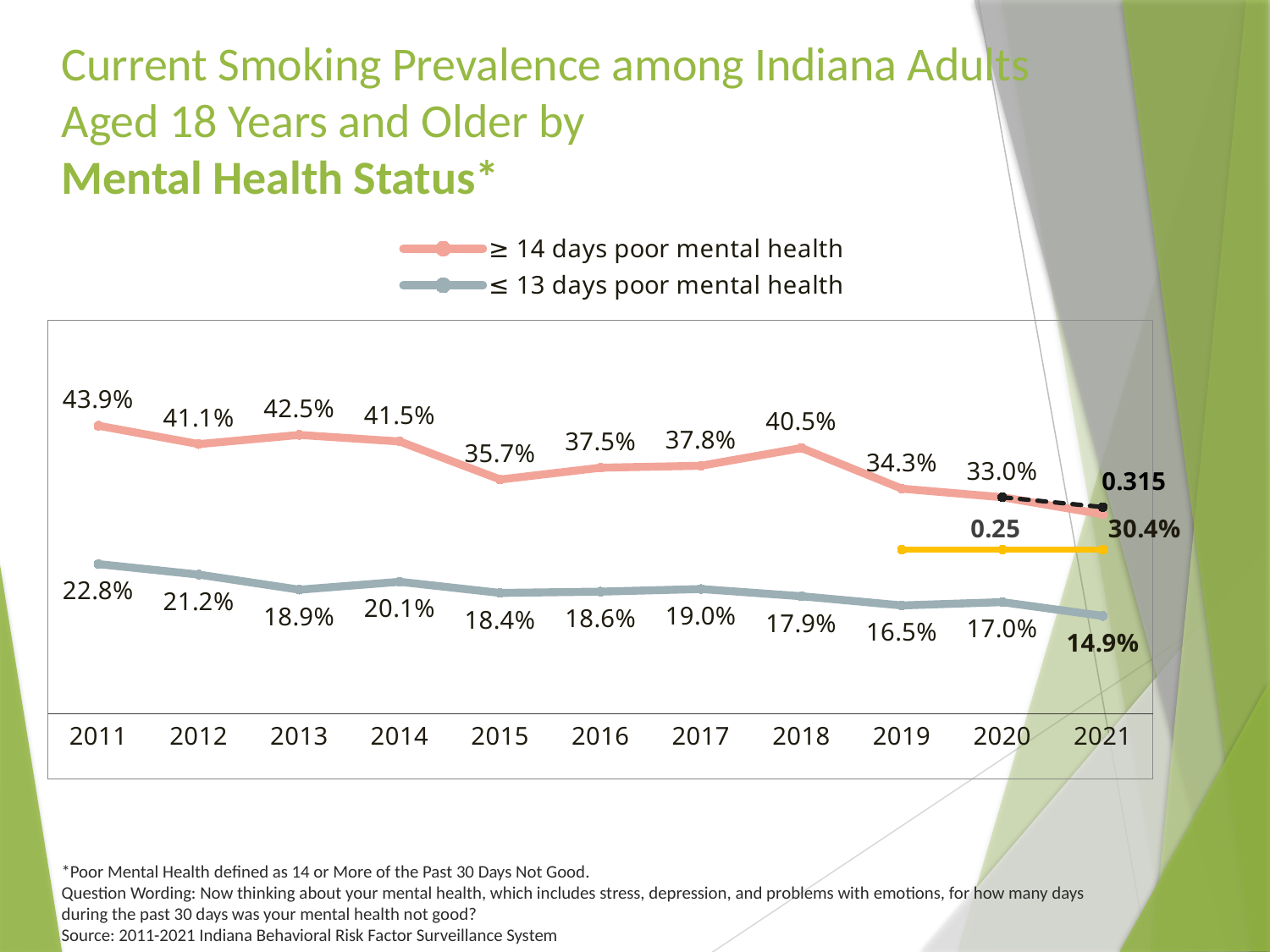
What is the current smoking prevalence for adults with ≤ 13 days poor mental health in 2021? 14.9% What is the current smoking prevalence for adults with ≥ 14 days poor mental health in 2011? 43.9% What is the value for the ≤ 13 days poor mental health series in 2015? 18.4% What kind of chart is shown on the slide? Line chart What is the difference between the ≥ 14 days and ≤ 13 days poor mental health values in 2021? 15.5 percentage points Which series has the higher value in 2019: ≥ 14 days poor mental health or ≤ 13 days poor mental health? ≥ 14 days poor mental health In which year is the ≥ 14 days poor mental health series at its highest? 2011 How many series does the legend list? 2 Does the ≤ 13 days poor mental health series generally rise or fall from 2011 to 2021? Fall What is the value for the ≥ 14 days poor mental health series in 2018? 40.5% How many years are shown on the x axis of the chart? 11 In which year is the ≤ 13 days poor mental health series at its lowest? 2021